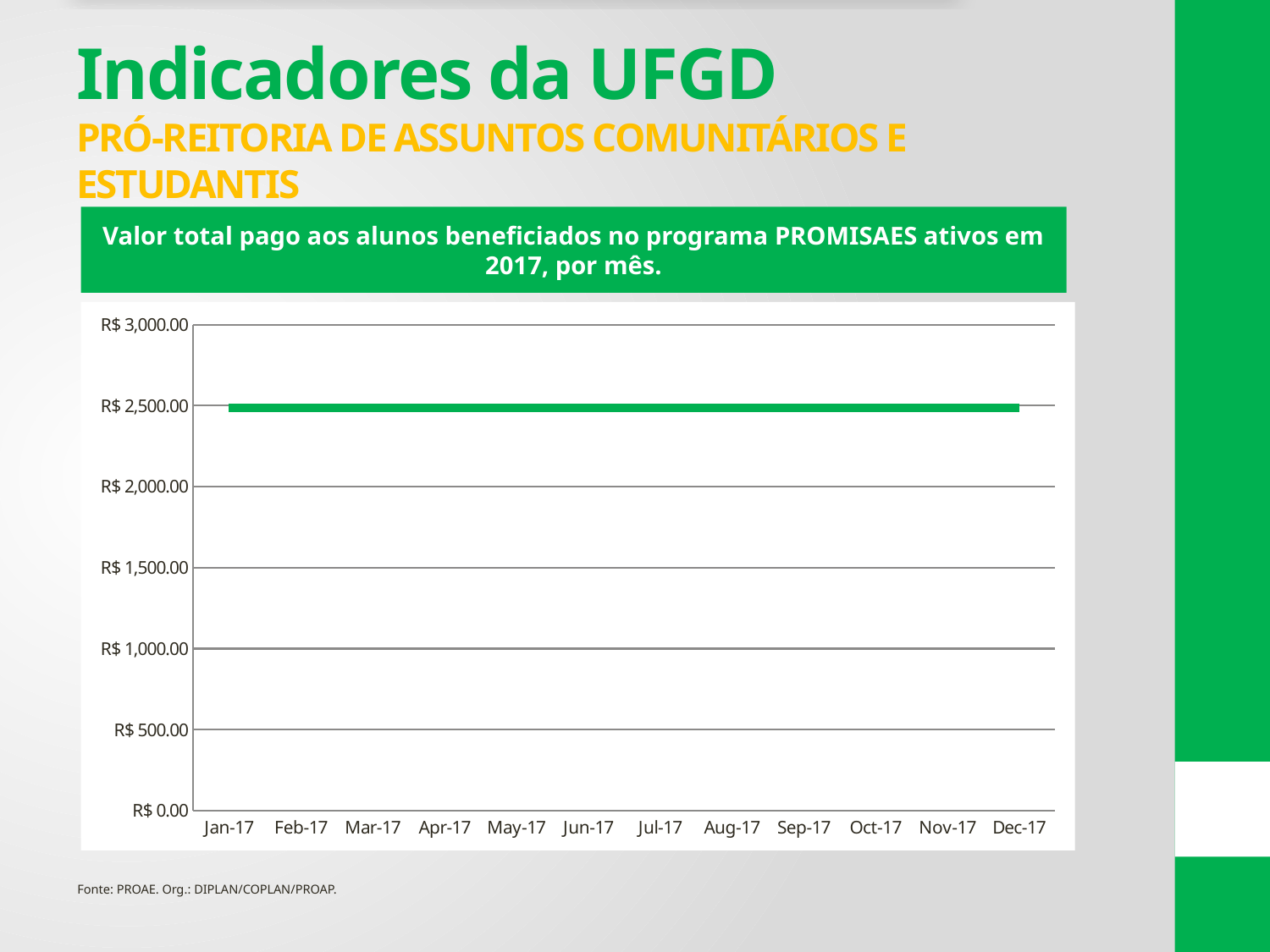
Is the value for Jan-17 greater or less than R$ 2,000.00? greater What is the title of the chart? Valor total pago aos alunos beneficiados no programa PROMISAES ativos em 2017, por mês. What is the last month label on the x axis? Dec-17 Is the value for Sep-17 greater or less than R$ 1,000.00? greater What is the highest value shown on the y axis of the chart? R$ 3,000.00 Is the value for Jun-17 greater or less than R$ 1,500.00? greater What kind of chart is shown on the slide? line chart Do the values rise, fall, or stay flat from Jan-17 to Dec-17? stay flat What is the first month label on the x axis? Jan-17 How many months are plotted along the x axis of the chart? 12